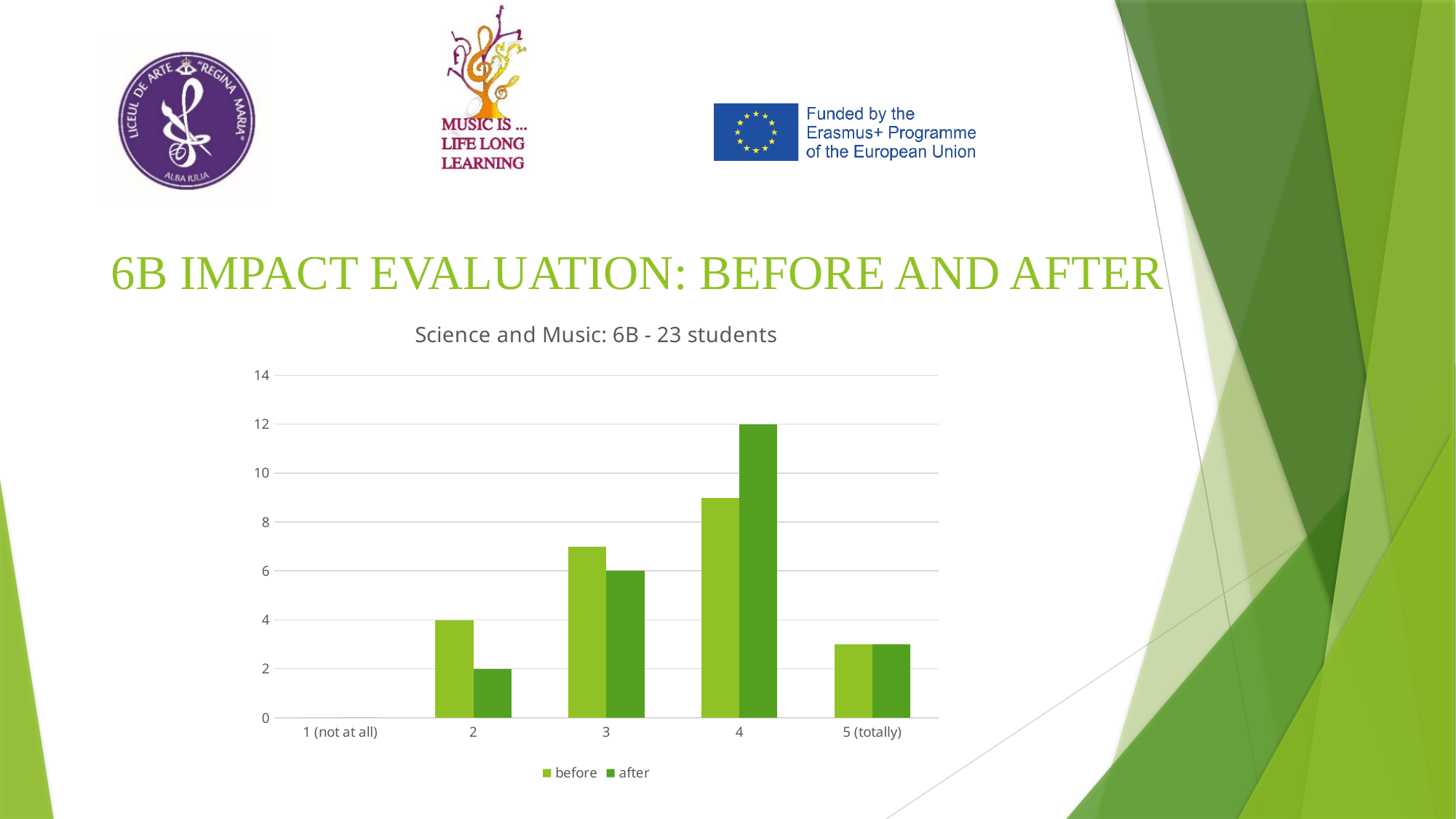
What is the value for 'after' at category 3? 6 What is the title of the chart? Science and Music: 6B - 23 students At category 2, which is larger, 'before' or 'after'? before What type of chart is shown on the slide? bar chart What is the value for 'after' at category 4? 12 What is the value for 'after' at category 2? 2 Which category has the highest 'after' value? 4 Which category has the highest 'before' value? 4 How many series does the legend list? 2 What is the value for 'before' at category 2? 4 Is the 'before' value for category 4 greater or less than 10? less How many categories are shown on the x axis? 5